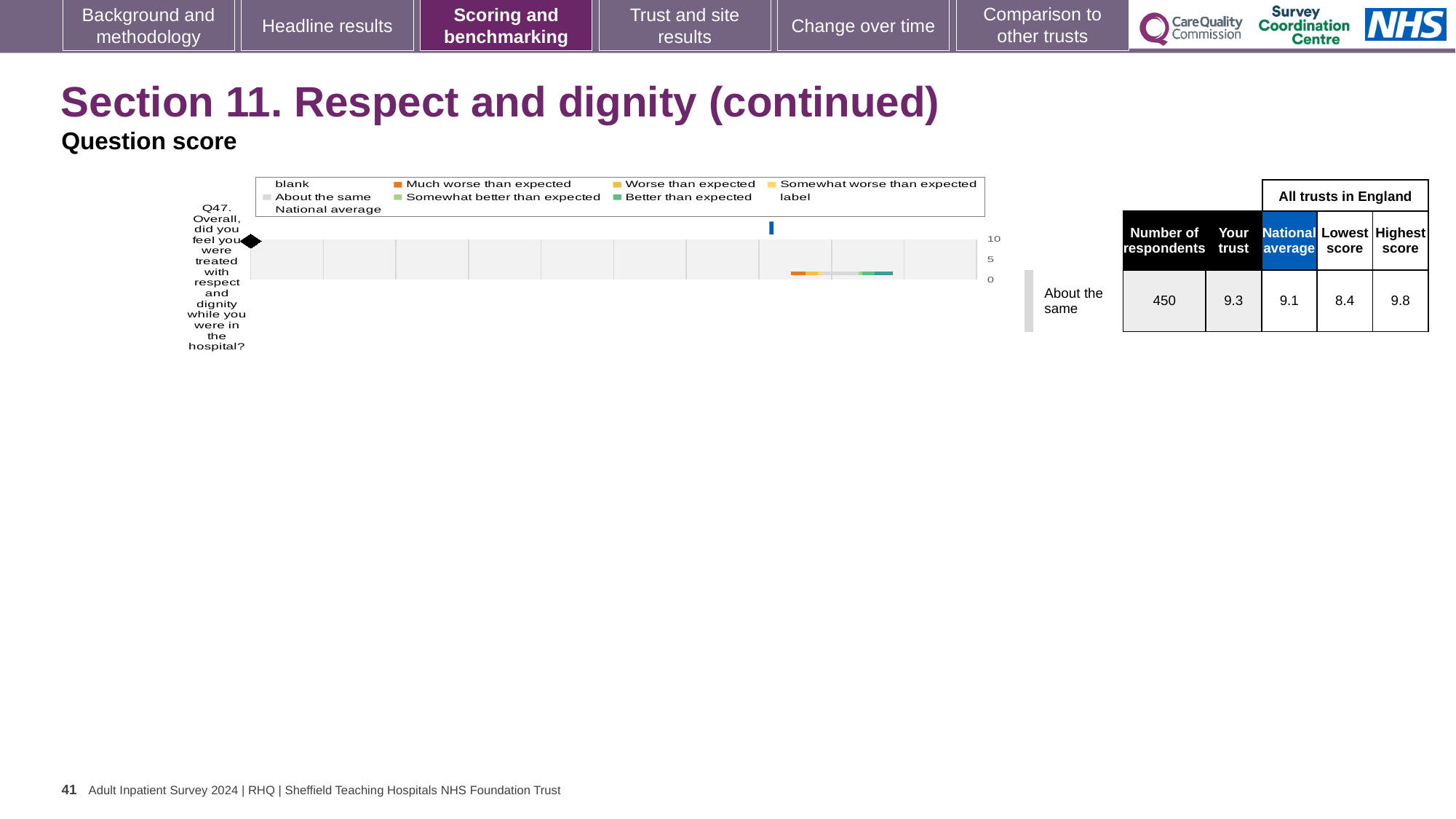
Which question number is plotted in the chart? Q47 What is the difference between the highest score and the lowest score for Q47 in the table? 1.4 In the table, what is the national average score for Q47? 9.1 In the table, what is the 'Your trust' score for Q47? 9.3 What is the lowest score among all trusts in England for Q47? 8.4 What benchmark category is shown for Q47 next to the chart? About the same How many survey questions are plotted in the chart? 1 In the table, how many respondents are recorded for Q47? 450 What kind of chart is shown on the slide? bar chart Which is larger for Q47: the 'Your trust' score or the national average? Your trust What is the highest tick value shown on the chart's axis? 10